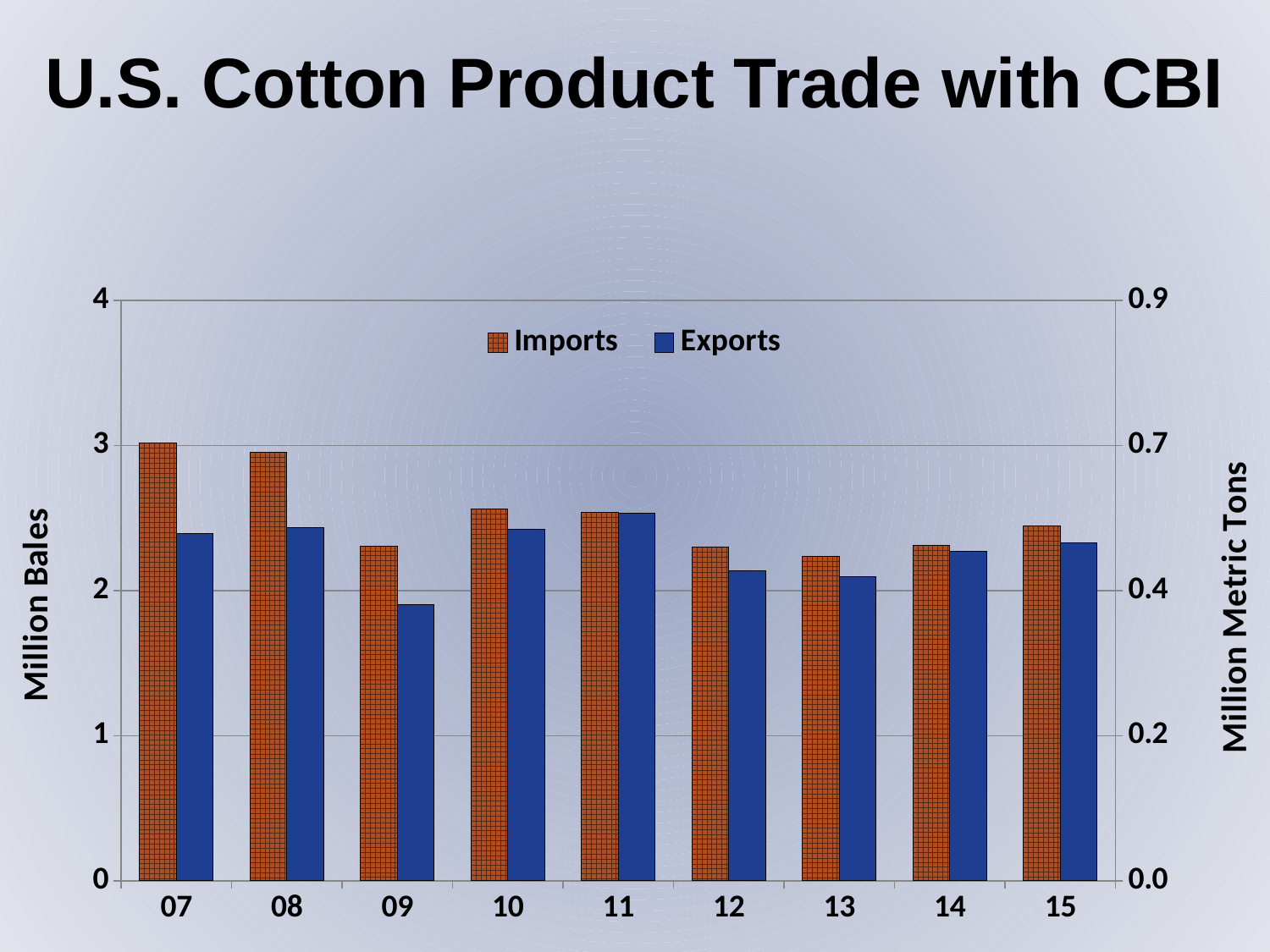
In 07, which is larger, Imports or Exports? Imports Is the Exports value for 09 greater or less than 2? less How many series does the legend list? 2 How many years are shown on the x axis? 9 Which year has the lowest Exports value? 09 What kind of chart is shown on the slide? bar chart Which year has the highest Imports value? 07 What is the title of the chart? U.S. Cotton Product Trade with CBI Do the Imports values rise or fall from 07 to 09? fall What is the label of the left vertical axis? Million Bales Is the Imports value for 09 greater or less than 2? greater